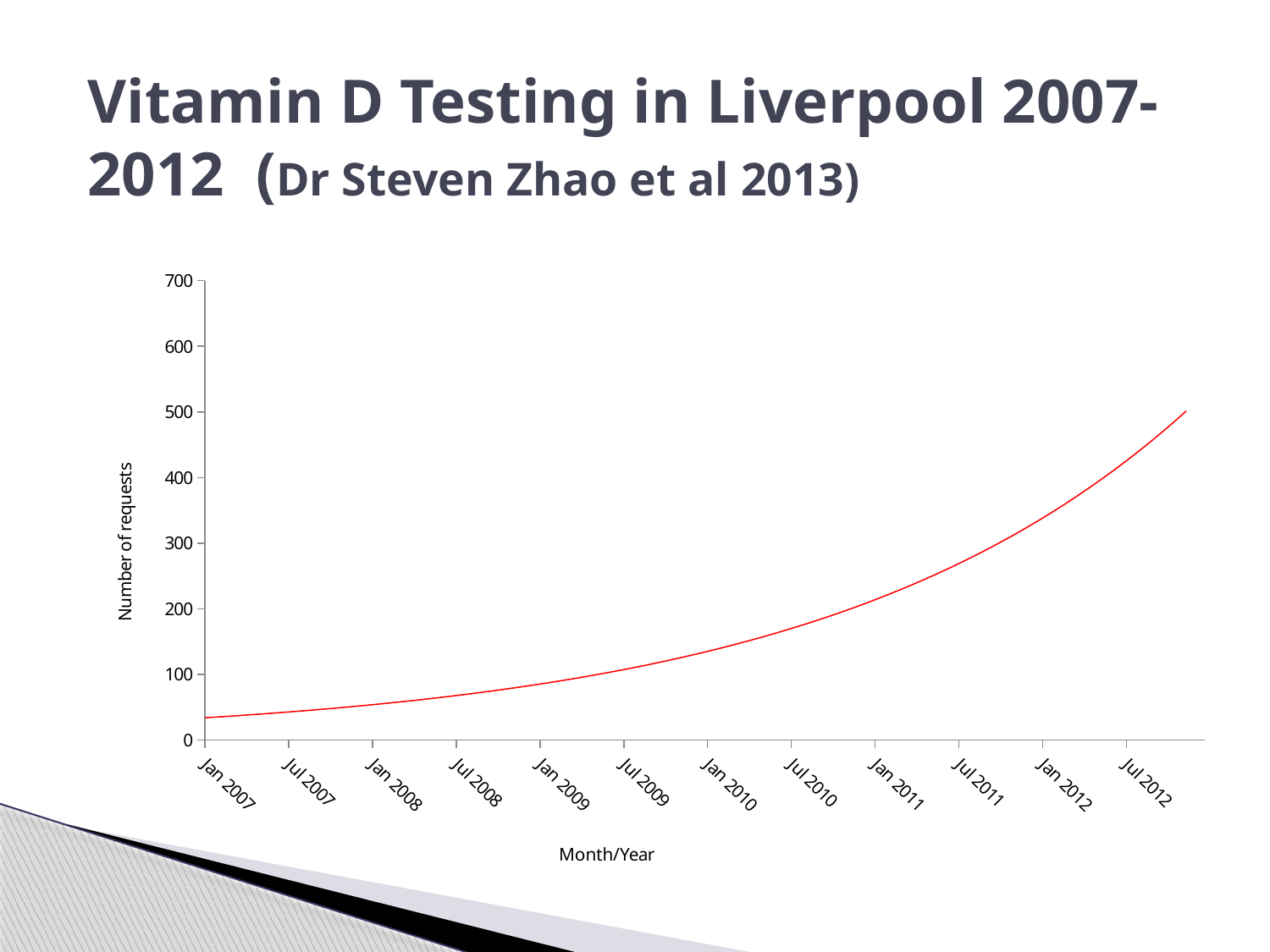
Which labelled month on the x axis has the highest number of requests? Jul 2012 What kind of chart is shown on the slide? line chart Is the value for Jan 2007 greater or less than 100? less Is the value for Jul 2011 greater or less than 200? greater What is the title of the vertical axis? Number of requests Do the number of requests rise or fall from Jan 2007 to Jul 2012? rise Is the value for Jul 2012 greater or less than 400? greater How many month/year labels are shown on the x axis? 12 Which labelled month on the x axis has the lowest number of requests? Jan 2007